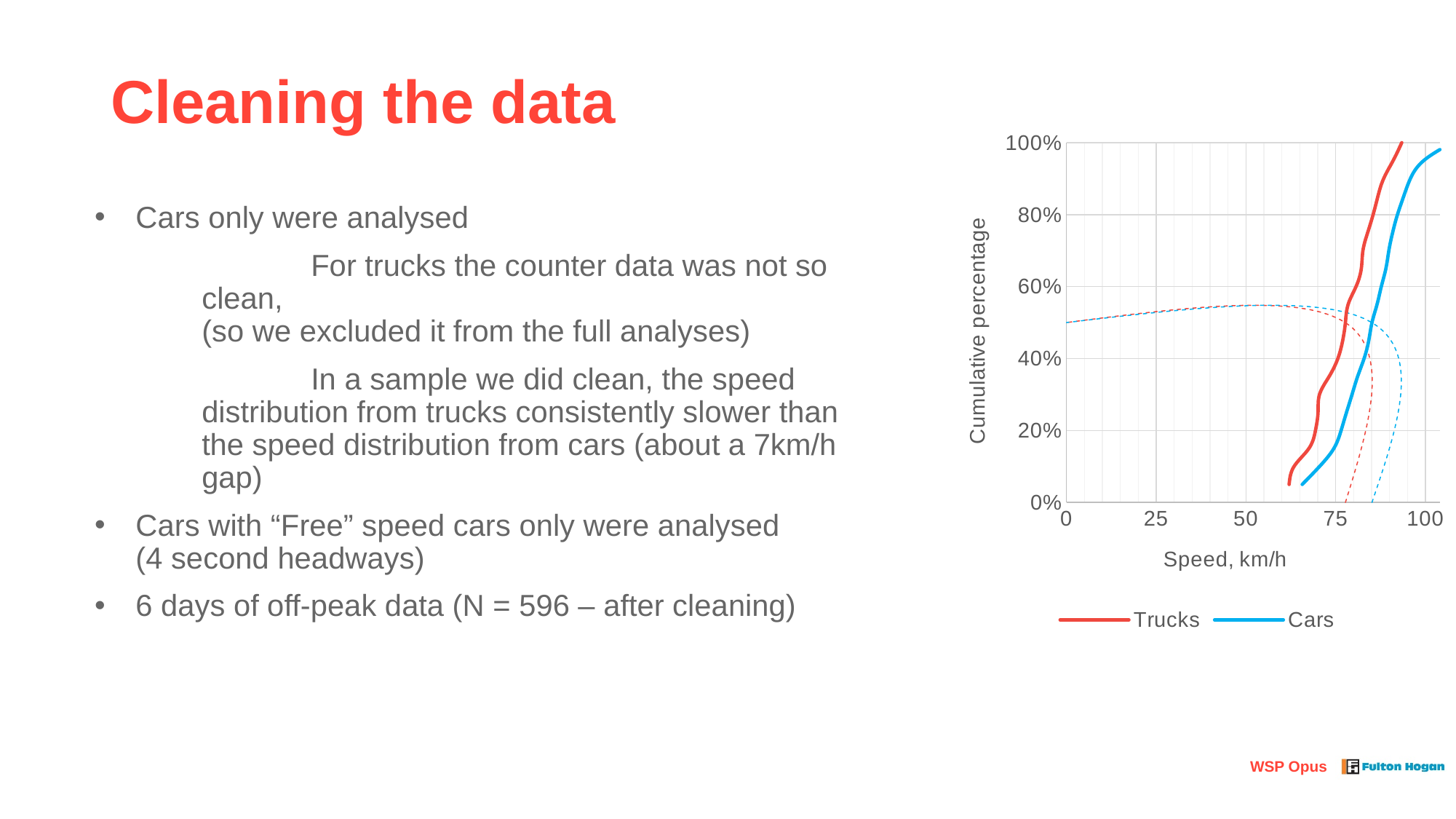
Which series reaches a cumulative percentage of 80% at the lower speed, Trucks or Cars? Trucks At a speed of 80 km/h, which series has the higher cumulative percentage, Trucks or Cars? Trucks How many series does the chart legend list? 2 Is the cumulative percentage for Trucks at 75 km/h greater or less than 20%? greater What is the highest value shown on the chart's x axis? 100 Do the cumulative percentage curves rise or fall as speed increases along the x axis? Rise What kind of chart is shown on the slide? Line chart What are the two series named in the chart legend? Trucks and Cars Is the cumulative percentage for Cars at 100 km/h greater or less than 80%? greater Is the cumulative percentage for Cars at 75 km/h greater or less than 40%? less What is the title of the chart's vertical axis? Cumulative percentage